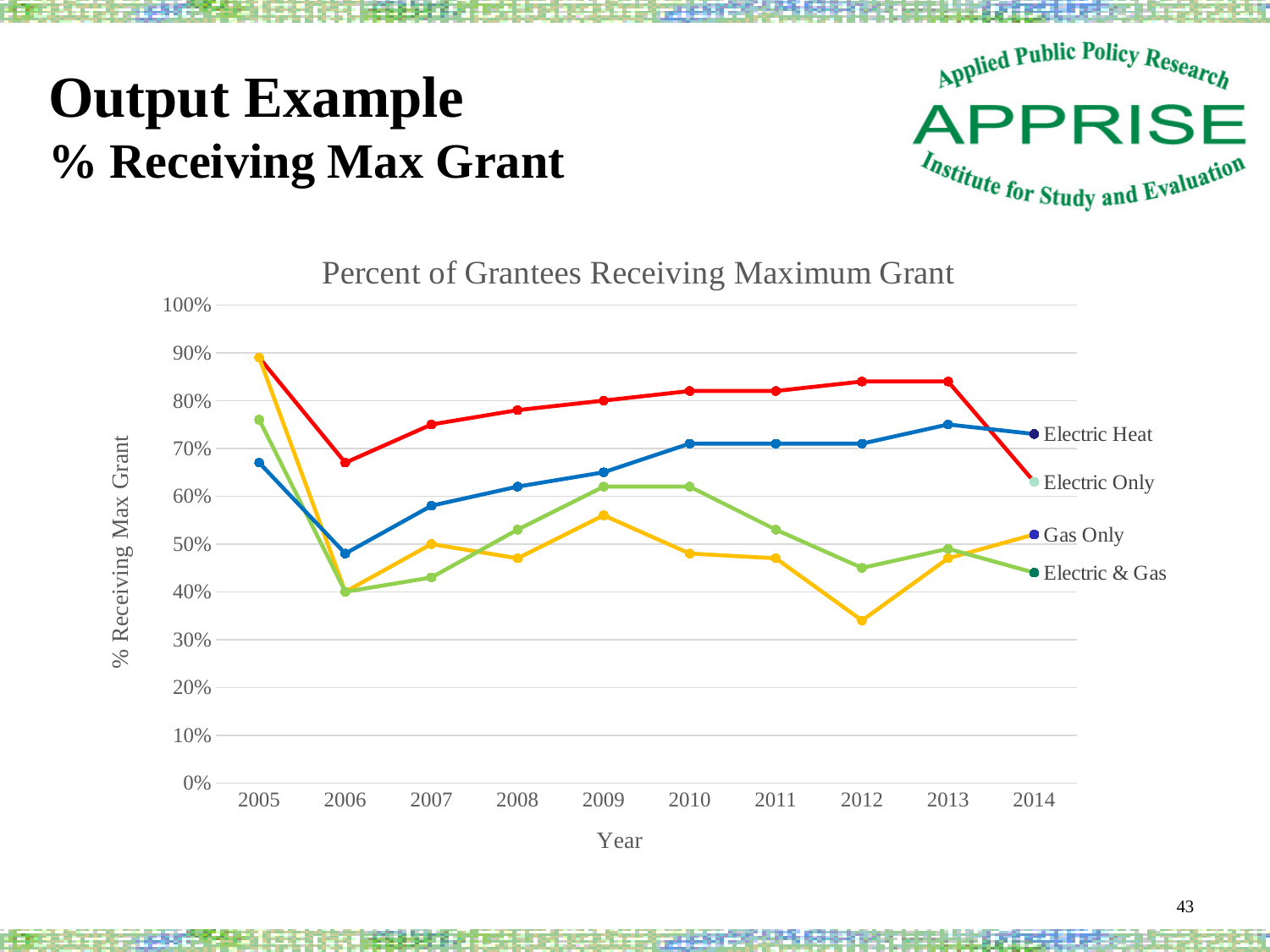
How many years are shown along the x axis? 10 Does the Electric Only series rise or fall from 2006 to 2013? rise In 2014, which is larger: Electric Heat or Electric Only? Electric Heat Which series has the lowest value in 2012? Gas Only What kind of chart is shown on the slide? line chart Is the value for Gas Only in 2012 greater or less than 40%? less What is the title of the x axis? Year Which series has the highest value in 2010? Electric Only How many series does the chart's legend list? 4 Is the value for Electric & Gas in 2009 greater or less than 50%? greater Is the value for Electric Heat in 2010 greater or less than 60%? greater